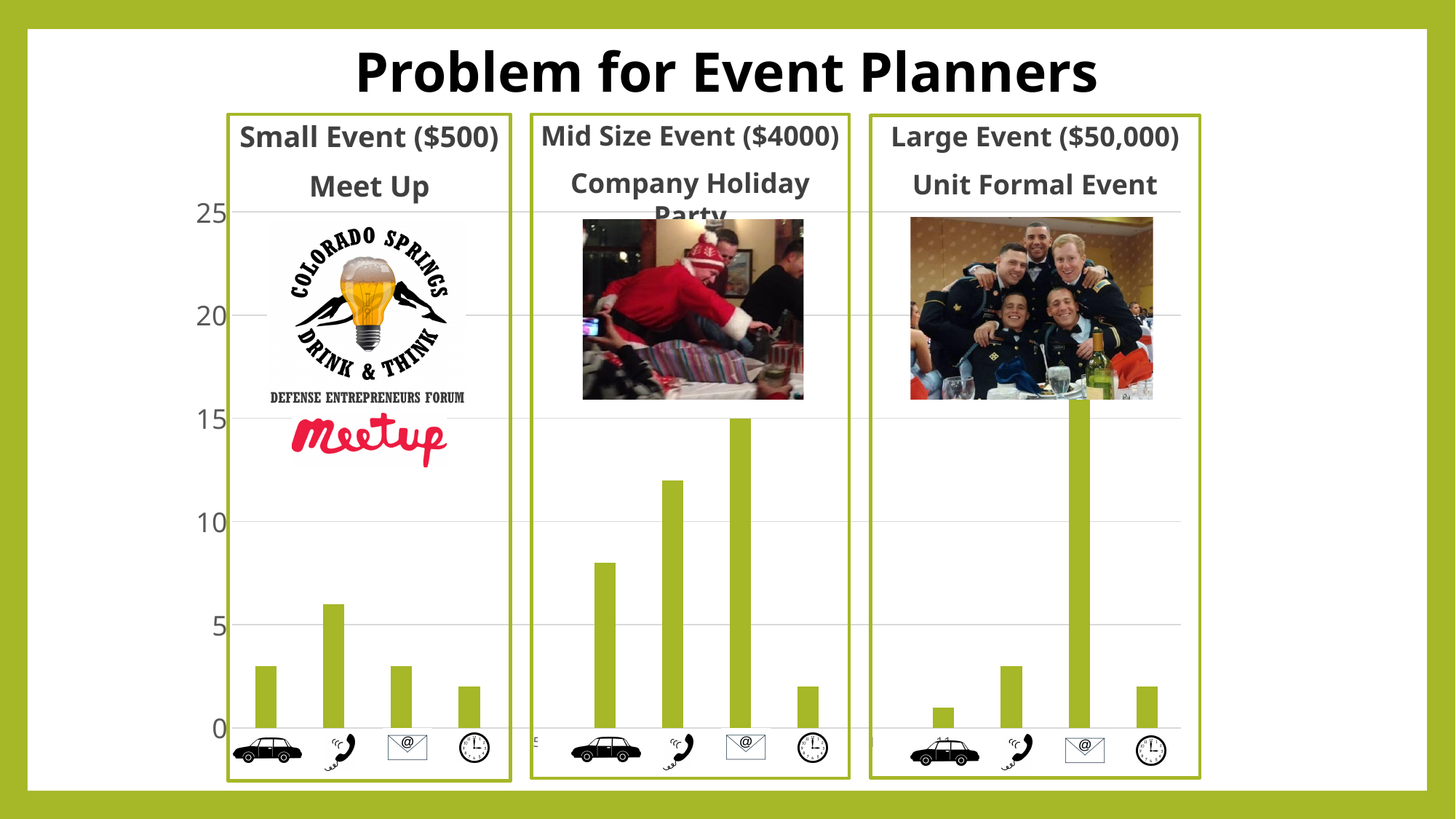
In the Mid Size Event ($4000) panel, which icon has the shortest bar? the clock icon In the Mid Size Event ($4000) panel, which icon has the tallest bar? the email icon How many bars are plotted in the Mid Size Event ($4000) panel? 4 In the Small Event ($500) panel, which icon has the tallest bar? the phone icon In the Small Event ($500) panel, is the value for the car icon greater or less than 5? less In the Large Event ($50,000) panel, is the value for the email icon greater or less than 15? greater Which is larger: the car icon bar in the Mid Size Event ($4000) panel or the car icon bar in the Large Event ($50,000) panel? Mid Size Event ($4000) What is the title of the slide? Problem for Event Planners In the Large Event ($50,000) panel, which icon has the shortest bar? the car icon In the Mid Size Event ($4000) panel, is the value for the phone icon greater or less than 10? greater What kind of chart is shown on the slide? bar chart